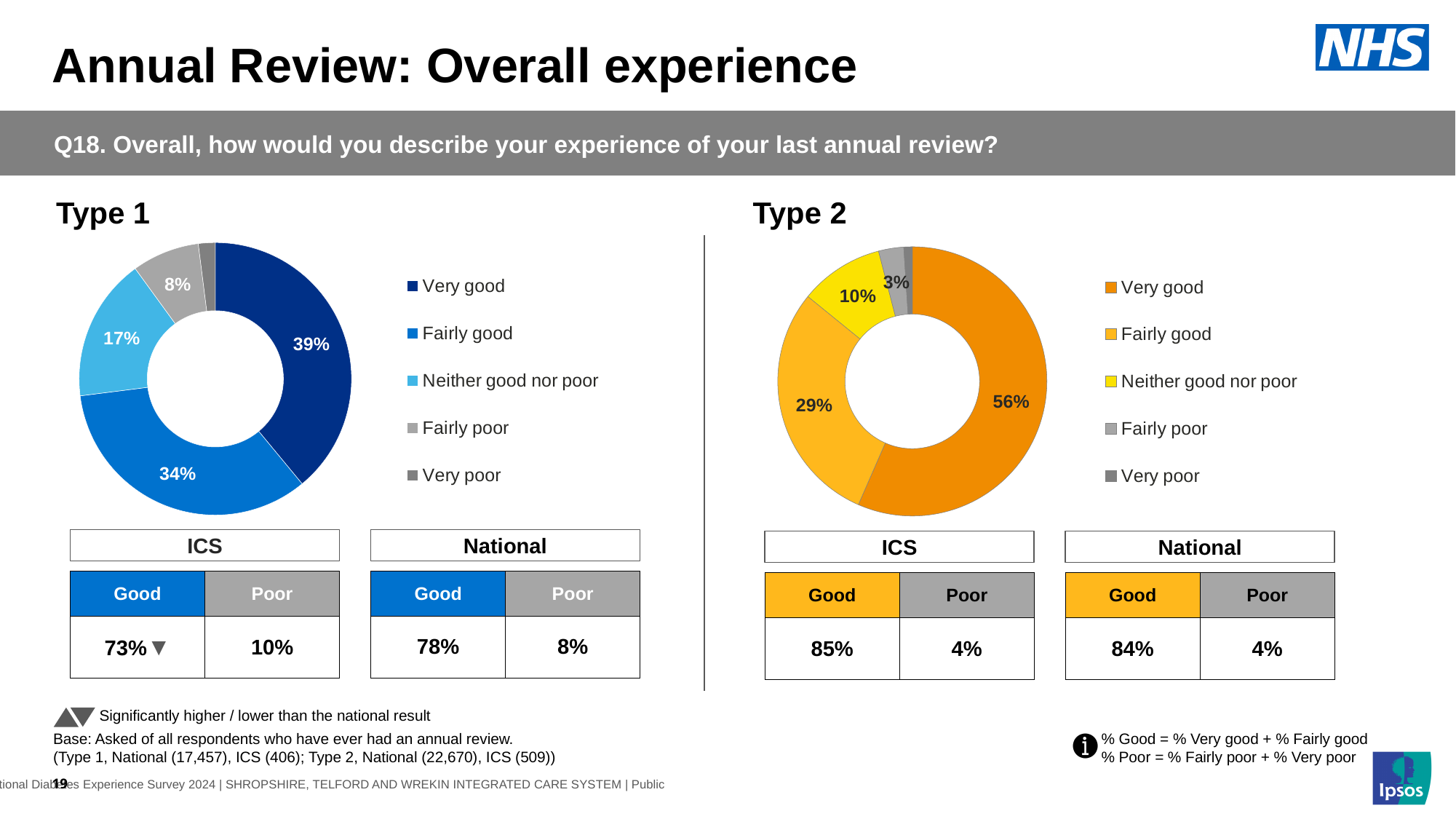
In the Type 1 chart, what percentage of respondents said Neither good nor poor? 17% In the Type 2 chart, which response category has the largest share? Very good How many response categories does the legend of the Type 1 chart list? 5 In the Type 2 chart, what percentage of respondents said Fairly poor? 3% In the Type 1 chart, what percentage of respondents said their experience was Very good? 39% What kind of chart is used to show the Type 2 results? Donut (pie) chart In the Type 2 chart, what percentage of respondents said their experience was Very good? 56% In the Type 2 chart, what is the difference between the Fairly good and Neither good nor poor shares? 19% In the Type 1 chart, which labelled response category has the smallest share? Fairly poor Which is larger: the Very good share in the Type 1 chart or the Very good share in the Type 2 chart? Type 2 In the Type 1 chart, what colour is used for the Very good segment? Dark blue In the Type 1 chart, what is the difference between the Very good and Fairly good shares? 5%